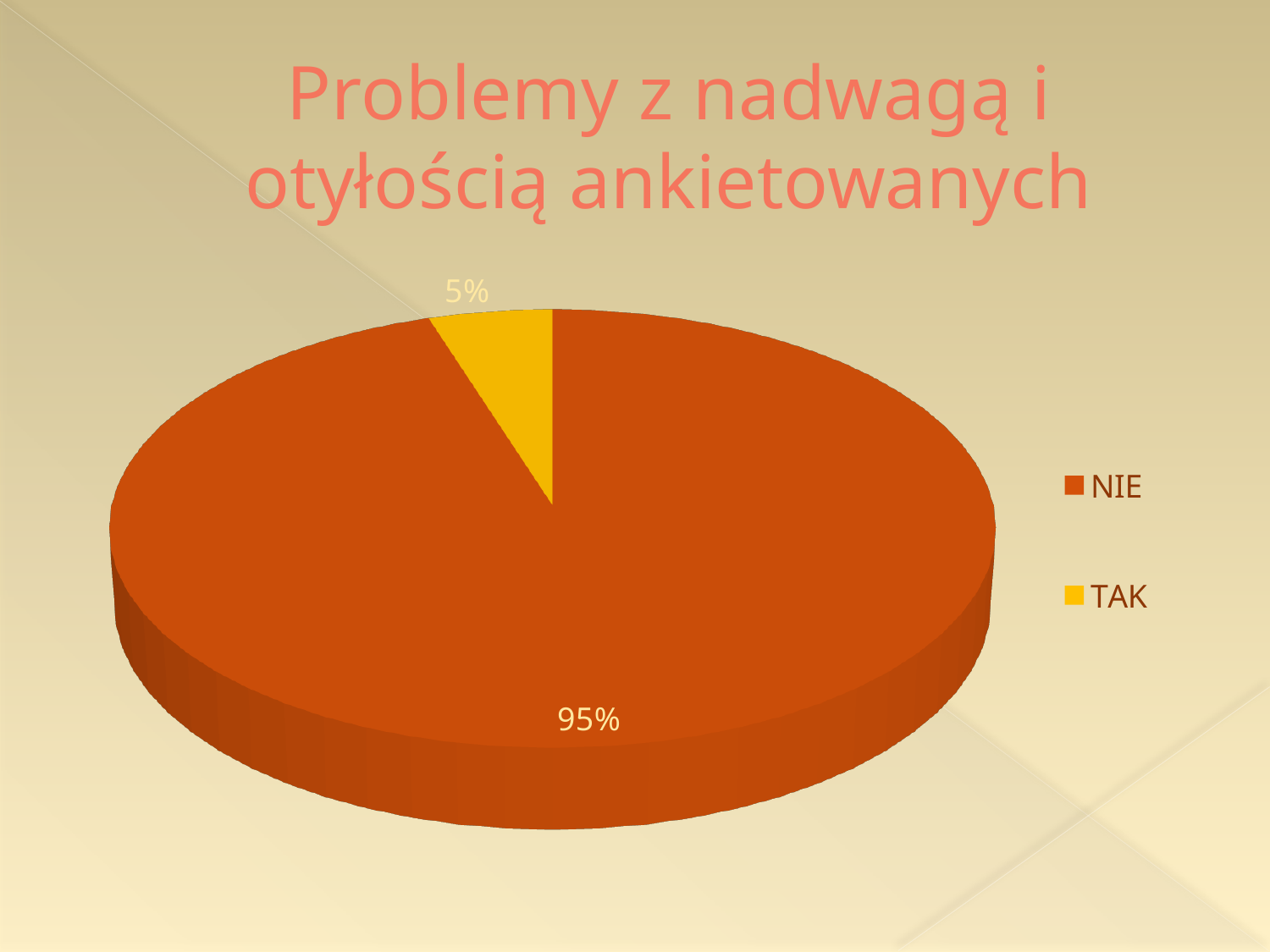
What is the difference in percentage points between the NIE and TAK slices? 90 Which is larger, the NIE slice or the TAK slice? NIE What share of the pie does NIE represent? 95% Which category has the smallest slice of the pie? TAK How many categories does the pie chart show? 2 How many entries does the legend list? 2 What is the title of the slide? Problemy z nadwagą i otyłością ankietowanych What kind of chart is shown on the slide? pie chart Which category has the largest slice of the pie? NIE What colour is the TAK slice? yellow What share of the pie does TAK represent? 5%